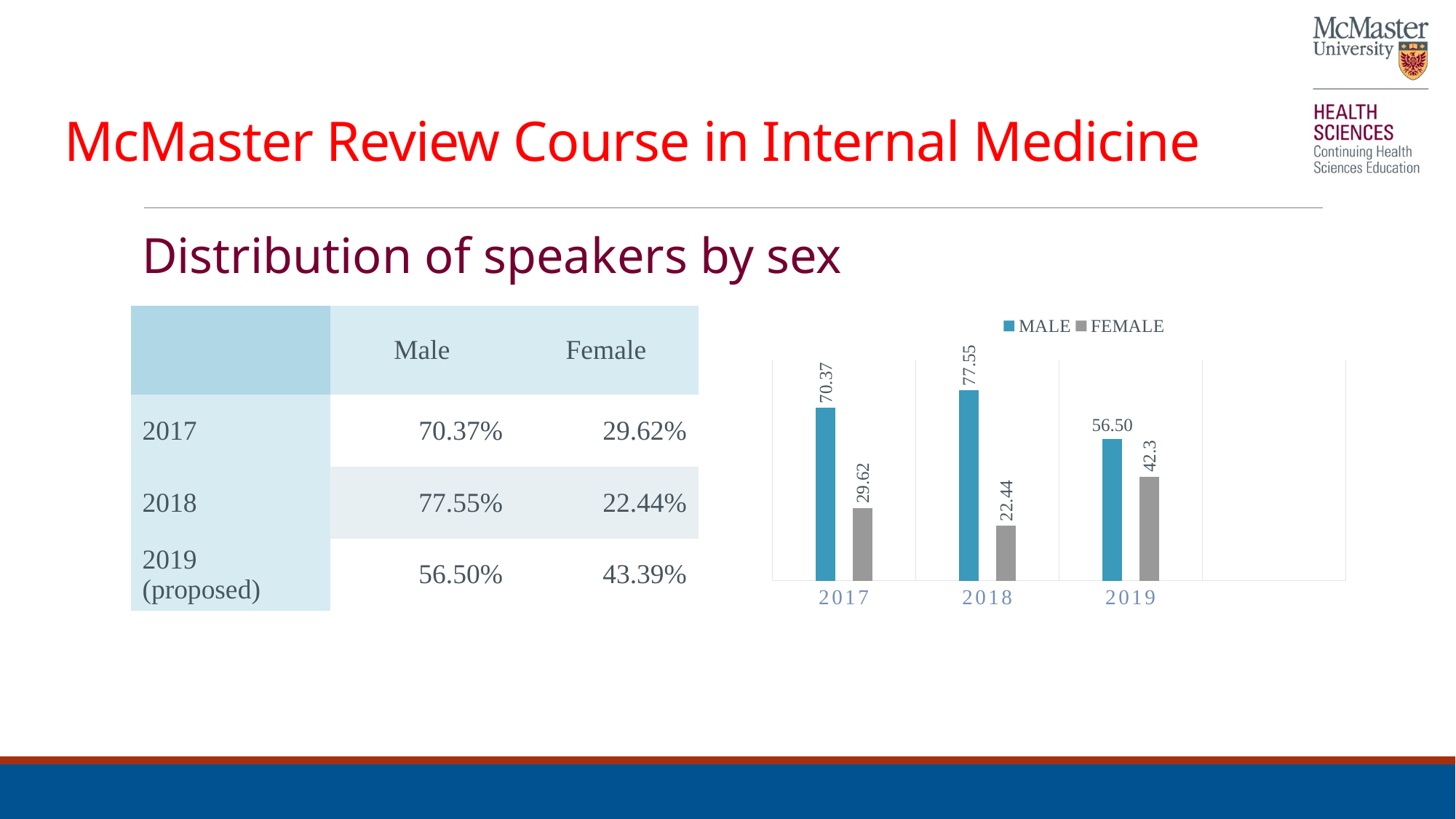
What is the difference between the MALE and FEMALE values for 2017? 40.75 What kind of chart is shown on the slide? bar chart What is the MALE value for 2017 in the chart? 70.37 Which year has the larger MALE value, 2018 or 2019? 2018 In which year is the MALE value highest? 2018 What is the MALE value for 2019 in the chart? 56.50 How many series does the chart legend list? 2 What colour are the MALE bars in the chart? blue In which year is the FEMALE value lowest? 2018 Does the MALE value rise or fall from 2018 to 2019? fall How many years are shown on the x axis of the chart? 3 What is the FEMALE value for 2018 in the chart? 22.44